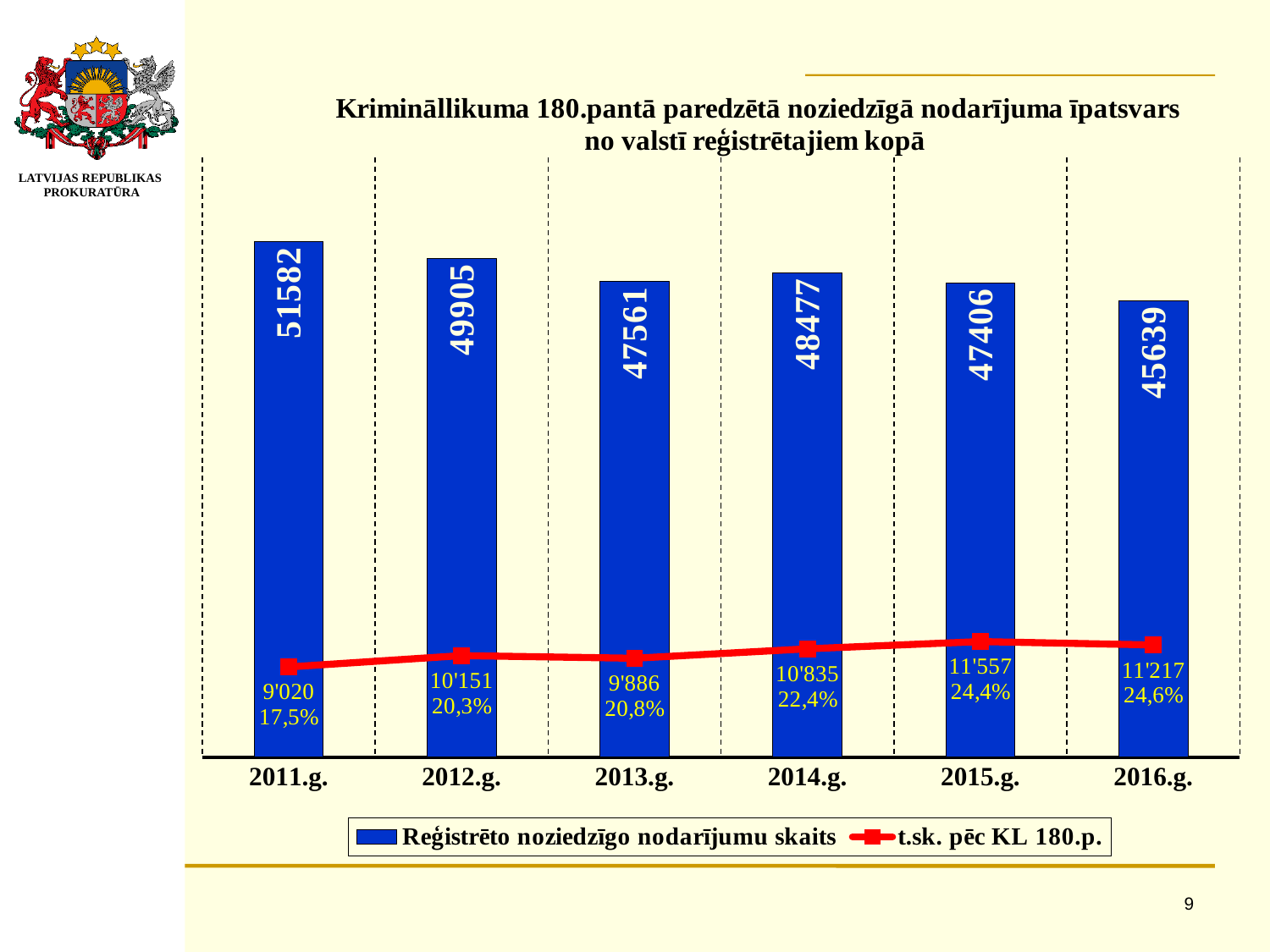
What is the count labelled on the 't.sk. pēc KL 180.p.' line for 2015.g.? 11'557 How many series does the legend list? 2 What kind of chart is this? Combined bar and line chart Which year has the highest bar value? 2011.g. What is the value of the bar for 2011.g.? 51582 What percentage is shown for 2014.g. on the 't.sk. pēc KL 180.p.' line? 22,4% Which is larger, the bar value for 2013.g. or for 2014.g.? 2014.g. What is the value of the bar for 2016.g.? 45639 Which year has the lowest bar value? 2016.g. Does the percentage shown on the 't.sk. pēc KL 180.p.' line rise or fall from 2011.g. to 2016.g.? Rise What is the difference between the bar values for 2011.g. and 2012.g.? 1677 How many years are shown on the x axis? 6